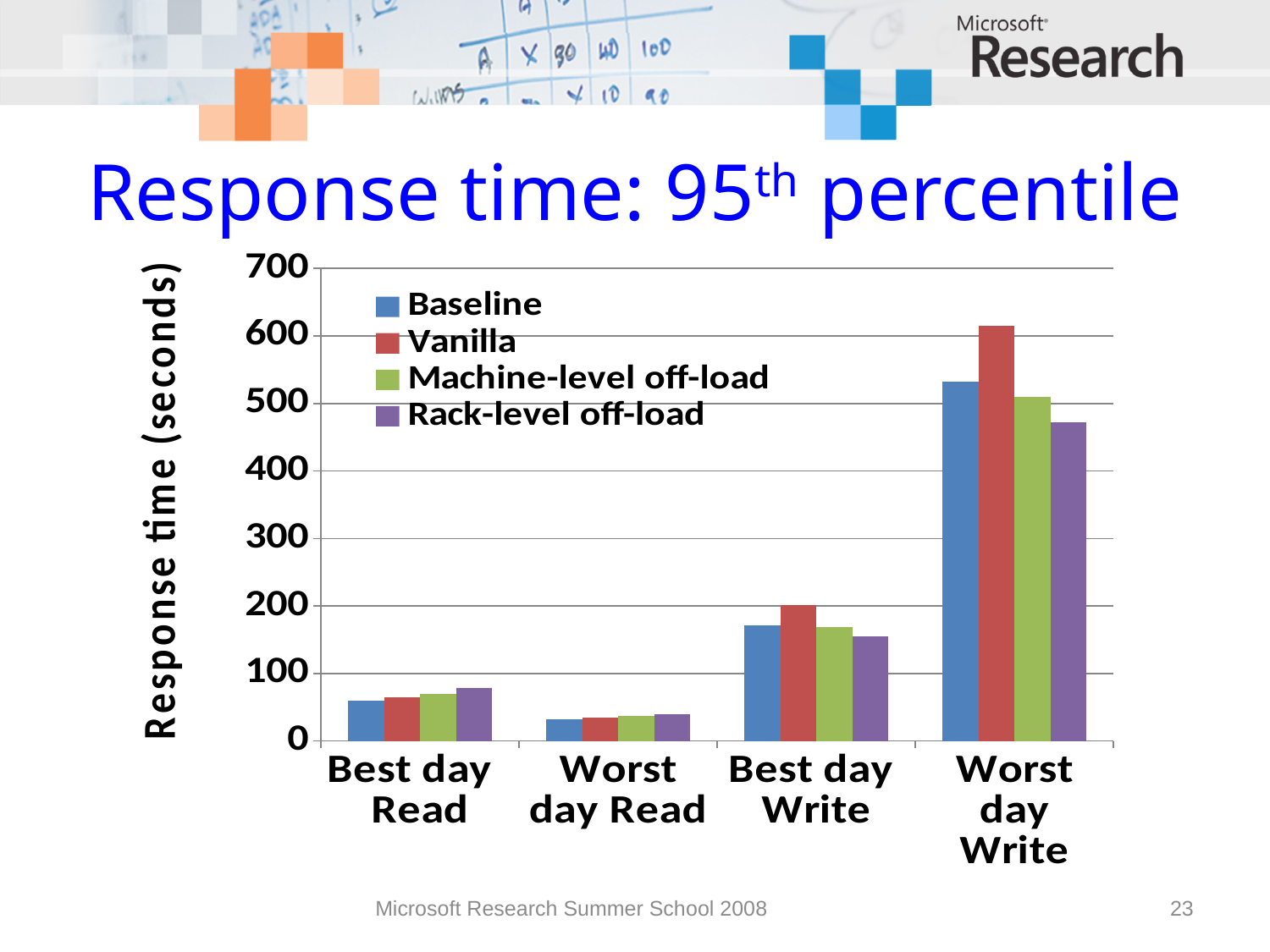
Which category has the lowest Baseline response time? Worst day Read Is the Rack-level off-load value for Worst day Write greater or less than 500? less In the Worst day Write category, which is larger: Vanilla or Rack-level off-load? Vanilla Is the Vanilla value for Worst day Write greater or less than 600? greater What is the label on the y axis? Response time (seconds) Is the Baseline value for Best day Read greater or less than 100? less Which series has the highest bar in the Worst day Write category? Vanilla How many categories are shown on the x axis? 4 Which category has the highest Vanilla response time? Worst day Write What kind of chart is shown on the slide? bar chart How many series does the legend list? 4